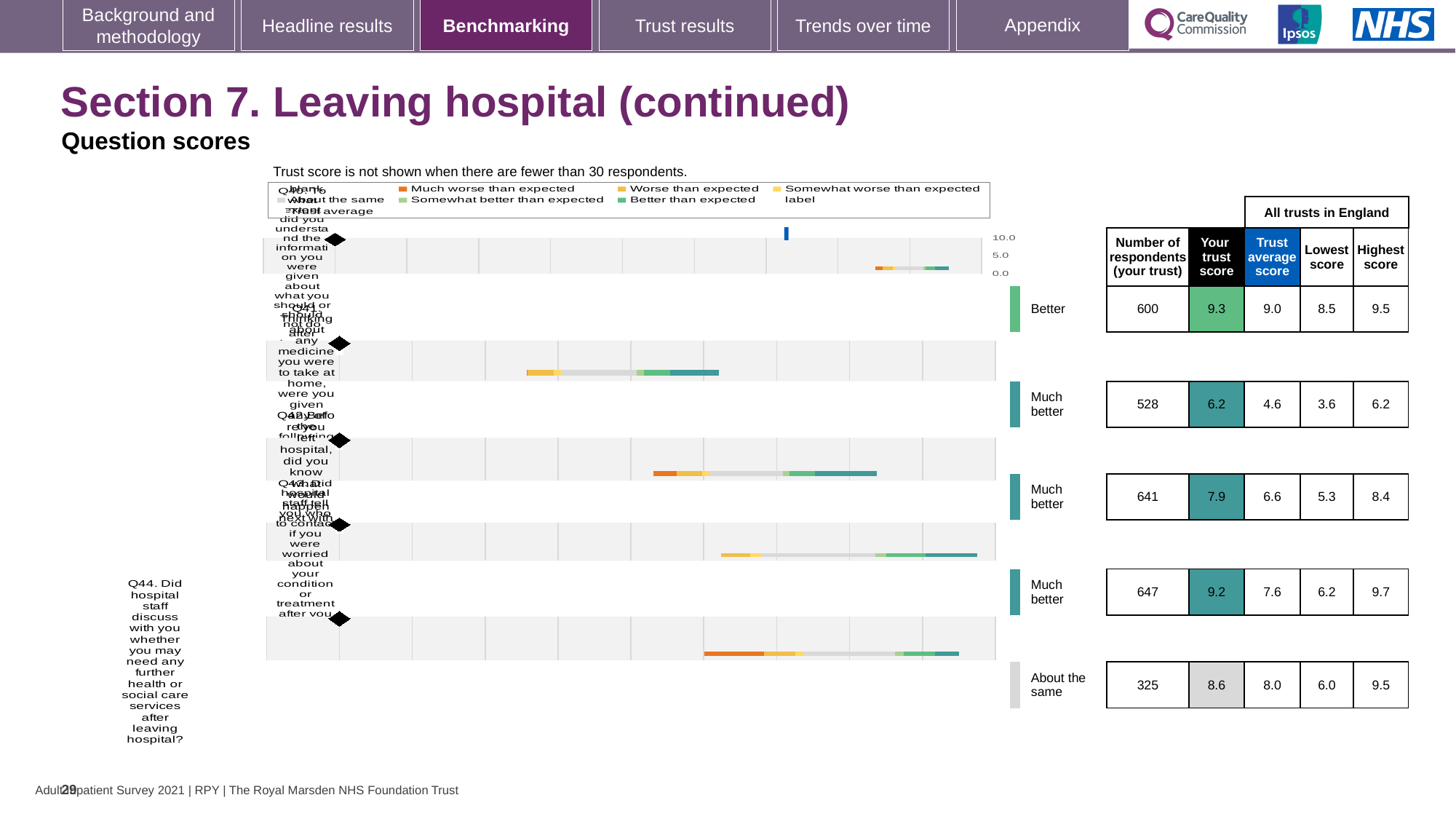
How many question rows are plotted in the benchmarking chart? 5 What is the 'Your trust score' for Q41 (thinking about any medicine you were to take at home)? 6.2 Among Q41, Q42, Q43 and Q44, which question has the highest 'Your trust score'? Q43 Among Q41, Q42, Q43 and Q44, which question has the lowest 'Your trust score'? Q41 What is the trust average score for Q44? 8.0 What is the 'Your trust score' for Q43 (Did hospital staff tell you who to contact if you were worried about your condition or treatment after you left hospital?)? 9.2 How many respondents (your trust) are shown for Q44? 325 What is the 'Your trust score' for Q44 (Did hospital staff discuss with you whether you may need any further health or social care services after leaving hospital?)? 8.6 What benchmark category is shown for Q44? About the same What is the highest score across all trusts in England for Q43? 9.7 By how much does the trust score for Q44 exceed the trust average score for Q44? 0.6 Which is larger: the 'Your trust score' for Q43 or for Q42? Q43